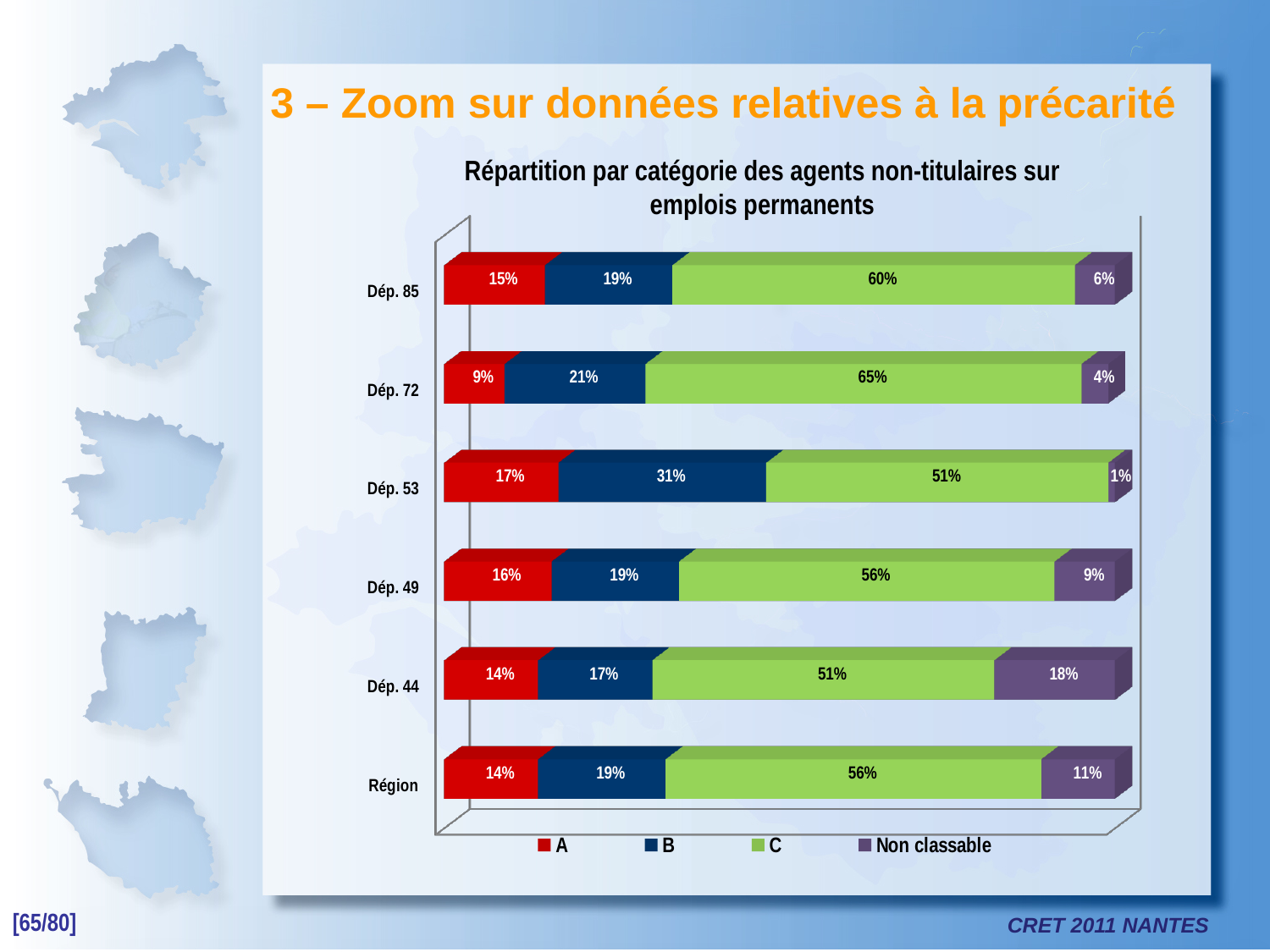
How many categories (rows) are shown on the y axis? 6 What kind of chart is shown on the slide? Stacked bar chart What is the difference between the category B values for Dép. 53 and Dép. 72? 10% What is the value for category B for Dép. 53? 31% Which is larger: the category A value for Dép. 53 or for Dép. 72? Dép. 53 Which category (row) has the lowest value for Non classable? Dép. 53 What is the value for category A for Région? 14% What is the value for Non classable for Dép. 44? 18% How many series does the legend list? 4 What is the title of the chart? Répartition par catégorie des agents non-titulaires sur emplois permanents Which category (row) has the highest value for category C? Dép. 72 What is the value for category C for Dép. 72? 65%